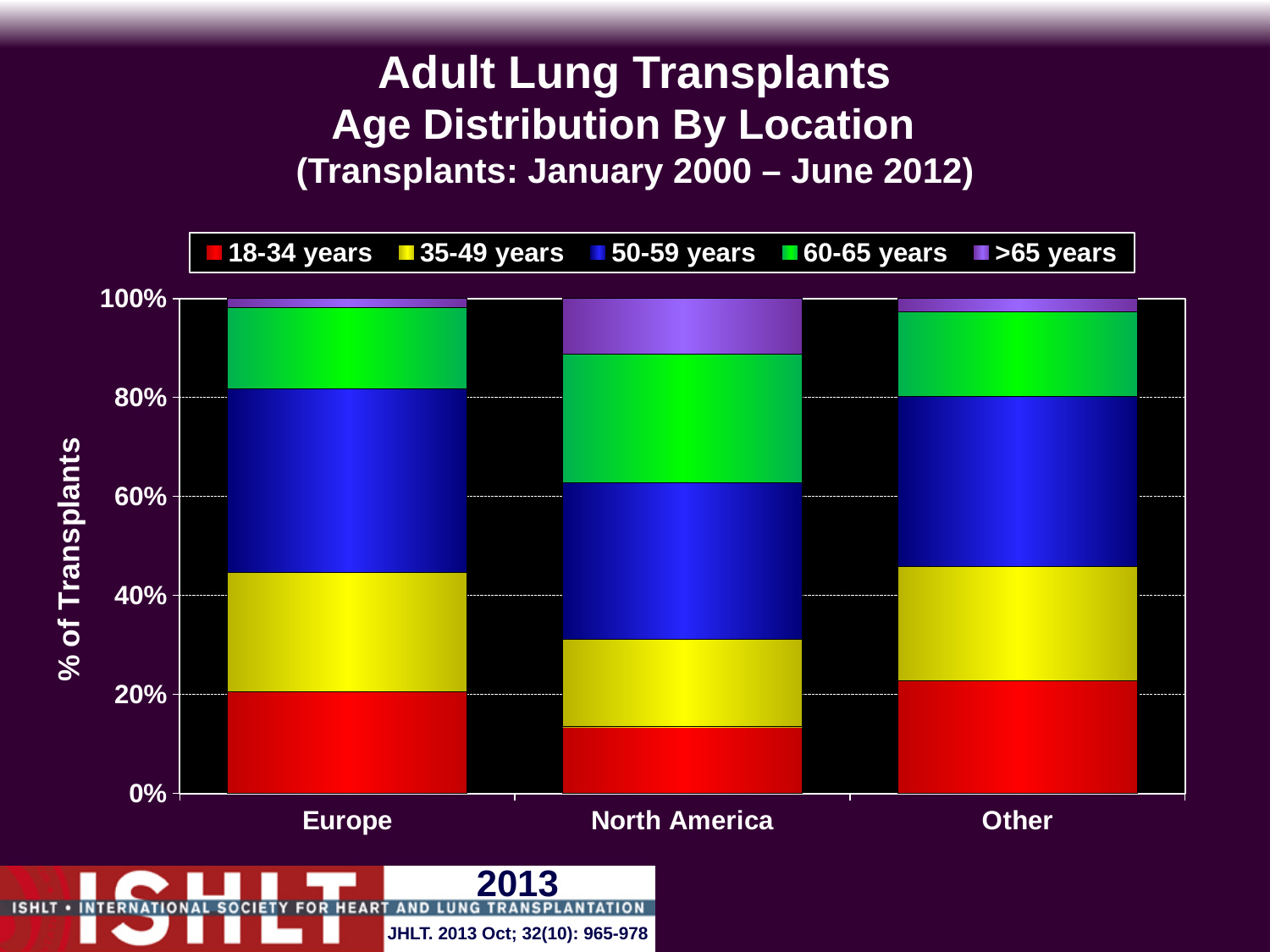
What colour represents the 50-59 years age group in the legend? Blue Which location has the smallest share of transplants in the 35-49 years age group? North America What is the label of the y axis? % of Transplants How many locations are shown on the x axis of the chart? 3 Which location has the largest share of transplants in the 60-65 years age group? North America How many age groups does the legend list? 5 What is the total height of the stacked bar for Europe? 100% Is the share of 18-34 years transplants in North America greater or less than 20%? less Which location has the largest share of transplants in the >65 years age group? North America Which location has the smallest share of transplants in the 18-34 years age group? North America What kind of chart is shown on the slide? Stacked bar chart Is the share of 18-34 years transplants in Europe larger or smaller than in North America? larger